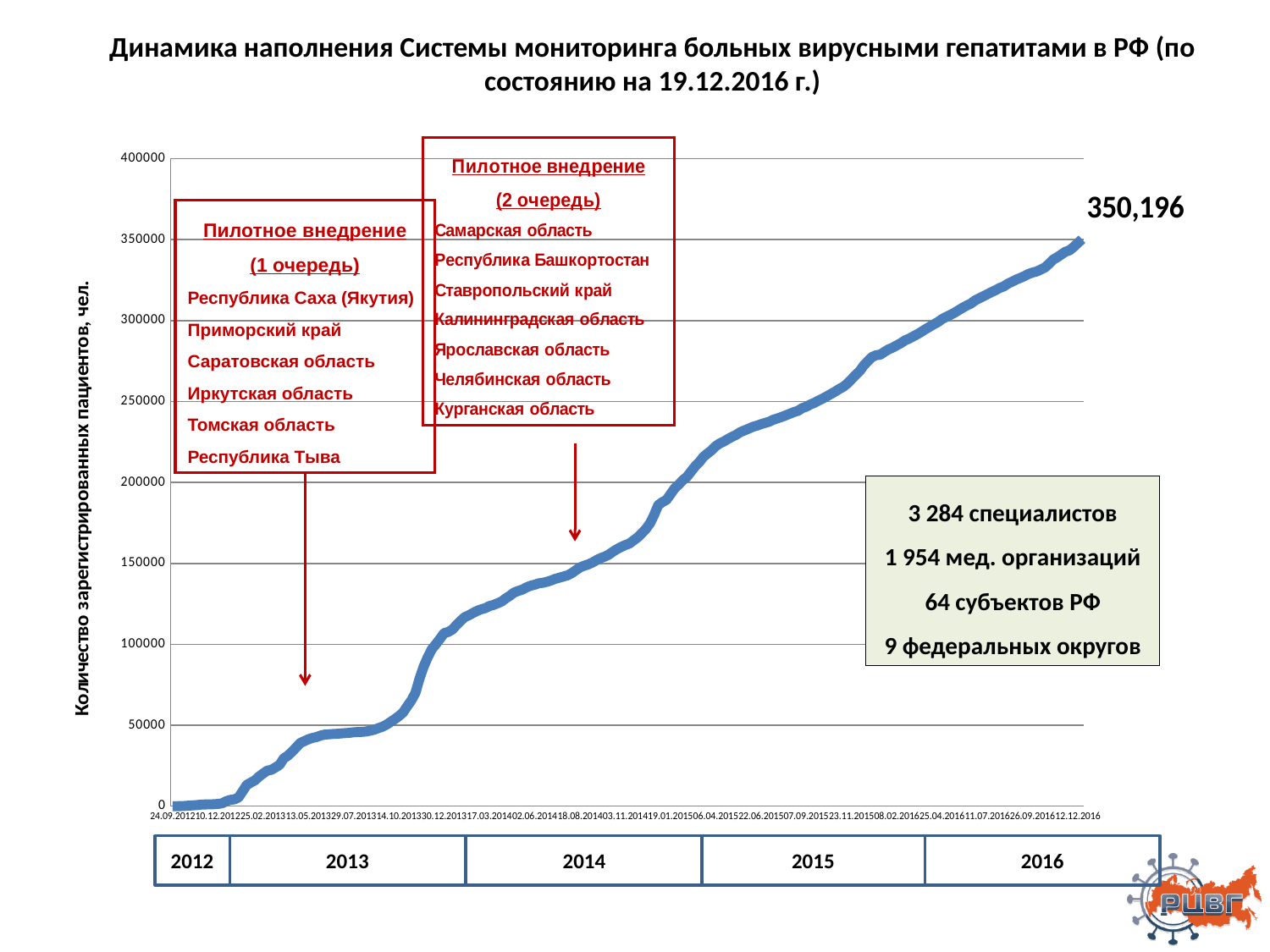
What is the title of the y axis? Количество зарегистрированных пациентов, чел. What kind of chart is shown on the slide? line chart Is the value at 26.09.2016 greater or less than 350000? less What is the value labelled at the end of the line (12.12.2016)? 350,196 Do the values rise or fall along the x axis from 2012 to 2016? rise How many years are labelled in the band below the x axis? 5 What is the highest tick value shown on the y axis? 400000 Is the value at 02.06.2014 greater or less than 100000? greater Is the value at 22.06.2015 greater or less than 200000? greater